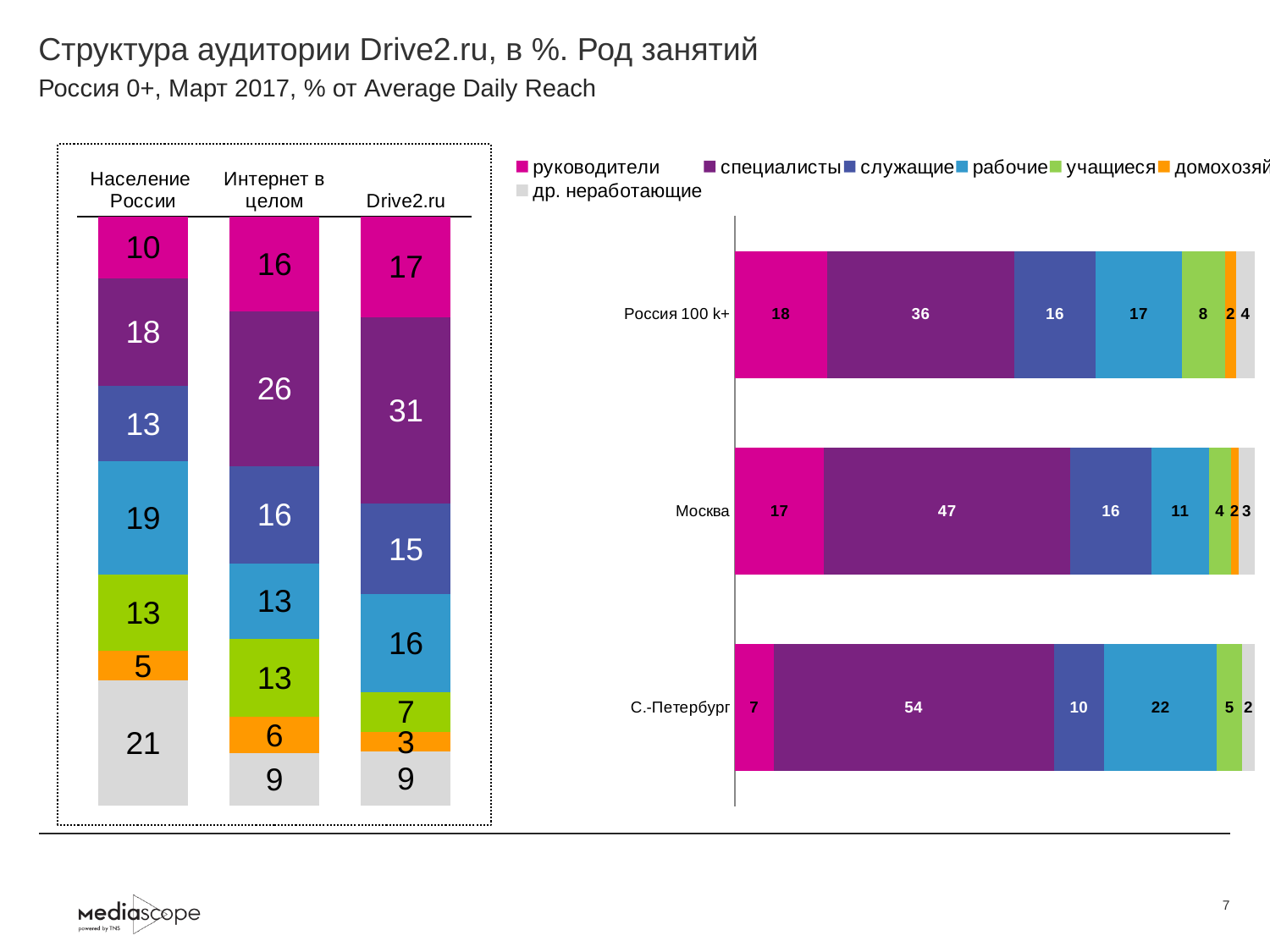
In the left chart, what is the value of the др. неработающие segment for Население России? 21 In the left chart, what is the total of the Drive2.ru stacked bar? 98 How many series does the legend of the right chart list? 7 In the right chart, what is the value of the рабочие segment for С.-Петербург? 22 In the left chart, what is the value of the специалисты segment for Drive2.ru? 31 In the right chart, which category has the highest специалисты value? С.-Петербург In the right chart, which category has the lowest руководители value? С.-Петербург In the left chart, which has the larger руководители value: Drive2.ru or Население России? Drive2.ru What kind of chart is the right chart? Stacked bar chart In the left chart, what is the difference between the специалисты values for Drive2.ru and Население России? 21 How many bars does the left chart show? 3 In the right chart, what is the value of the специалисты segment for Москва? 47